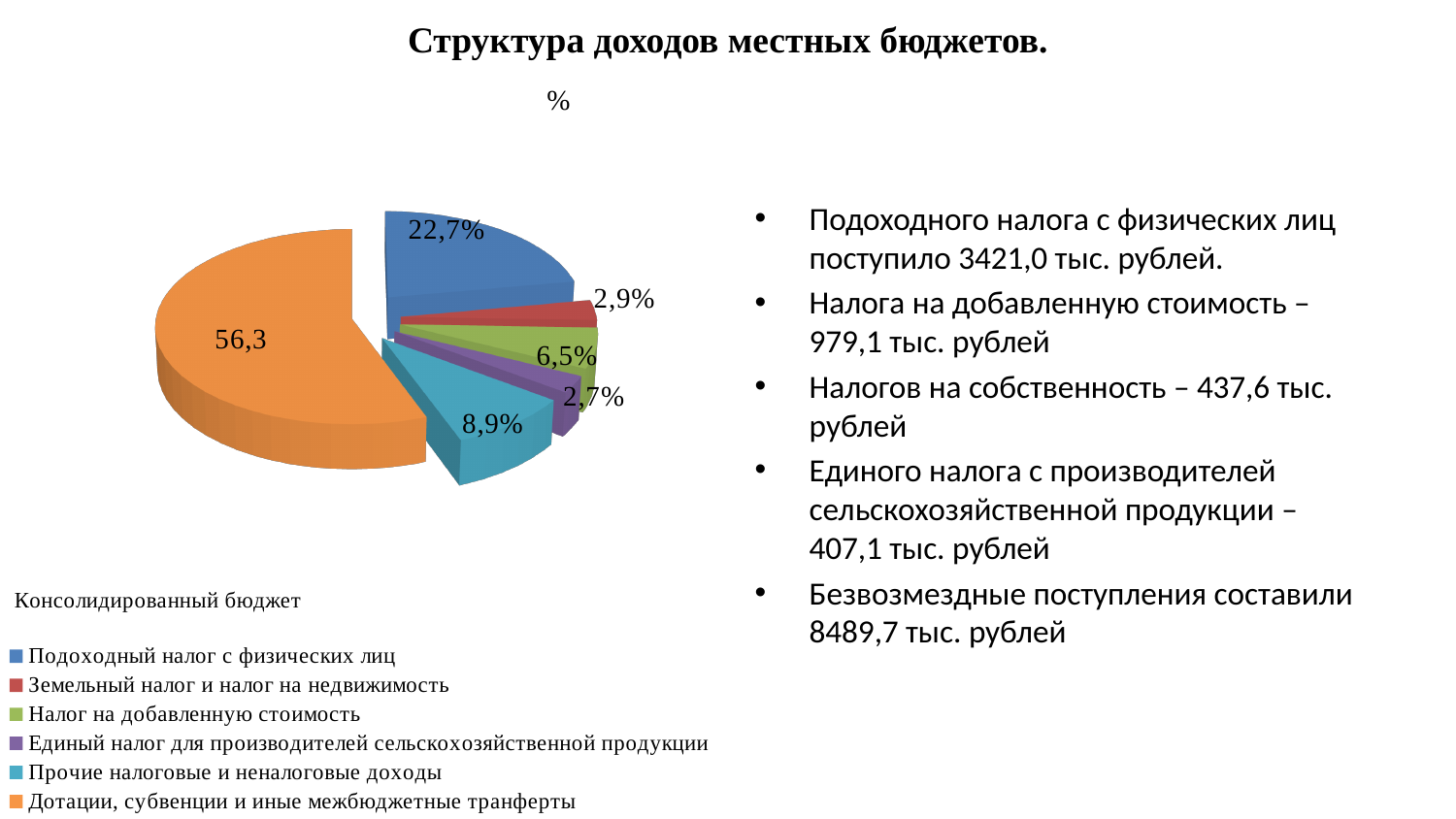
What colour is the slice for Дотации, субвенции и иные межбюджетные трансферты? orange What share is shown for Прочие налоговые и неналоговые доходы? 8,9% Which slice is larger: Подоходный налог с физических лиц or Налог на добавленную стоимость? Подоходный налог с физических лиц What share is shown for Налог на добавленную стоимость? 6,5% How many categories does the legend list? 6 Which category has the largest slice of the pie? Дотации, субвенции и иные межбюджетные трансферты What share of the pie is labelled for Подоходный налог с физических лиц? 22,7% What is the difference in percentage points between Подоходный налог с физических лиц and Прочие налоговые и неналоговые доходы? 13,8 What value is shown for Дотации, субвенции и иные межбюджетные трансферты? 56,3 What share is shown for Земельный налог и налог на недвижимость? 2,9% What kind of chart is shown on the slide? pie chart Which category has the smallest slice of the pie? Единый налог для производителей сельскохозяйственной продукции